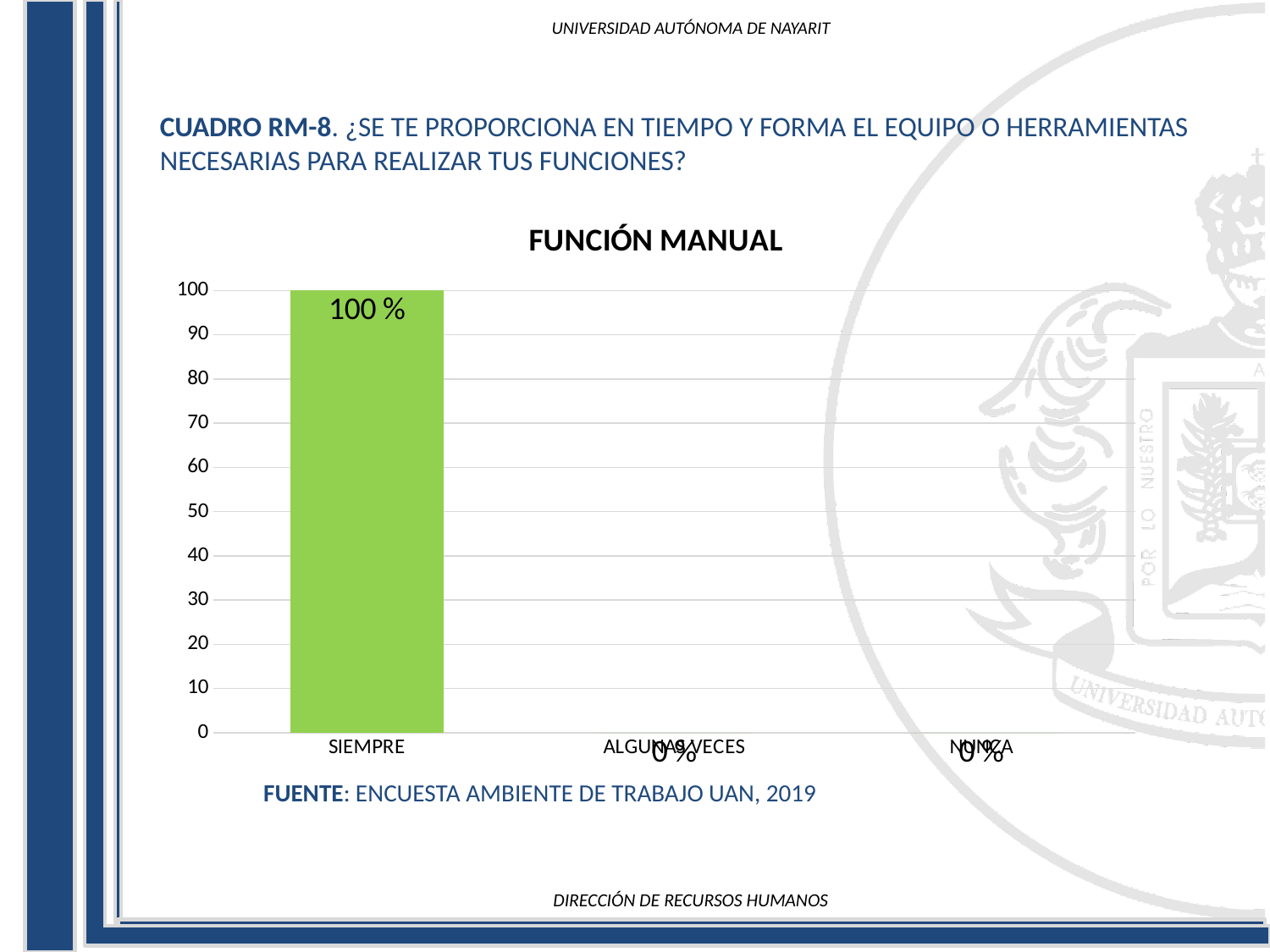
What is the value for ALGUNAS VECES? 0 % What is the title of the chart? FUNCIÓN MANUAL What is the difference between the values for SIEMPRE and NUNCA? 100 % Which is larger, the value for SIEMPRE or the value for ALGUNAS VECES? SIEMPRE What kind of chart is this? bar chart Do the values rise or fall from SIEMPRE to NUNCA along the x axis? fall How many categories are shown on the x axis? 3 What is the value for SIEMPRE? 100 % Is the value for SIEMPRE greater or less than 50? greater Which category has the highest value? SIEMPRE What is the highest value shown on the vertical axis? 100 What is the value for NUNCA? 0 %